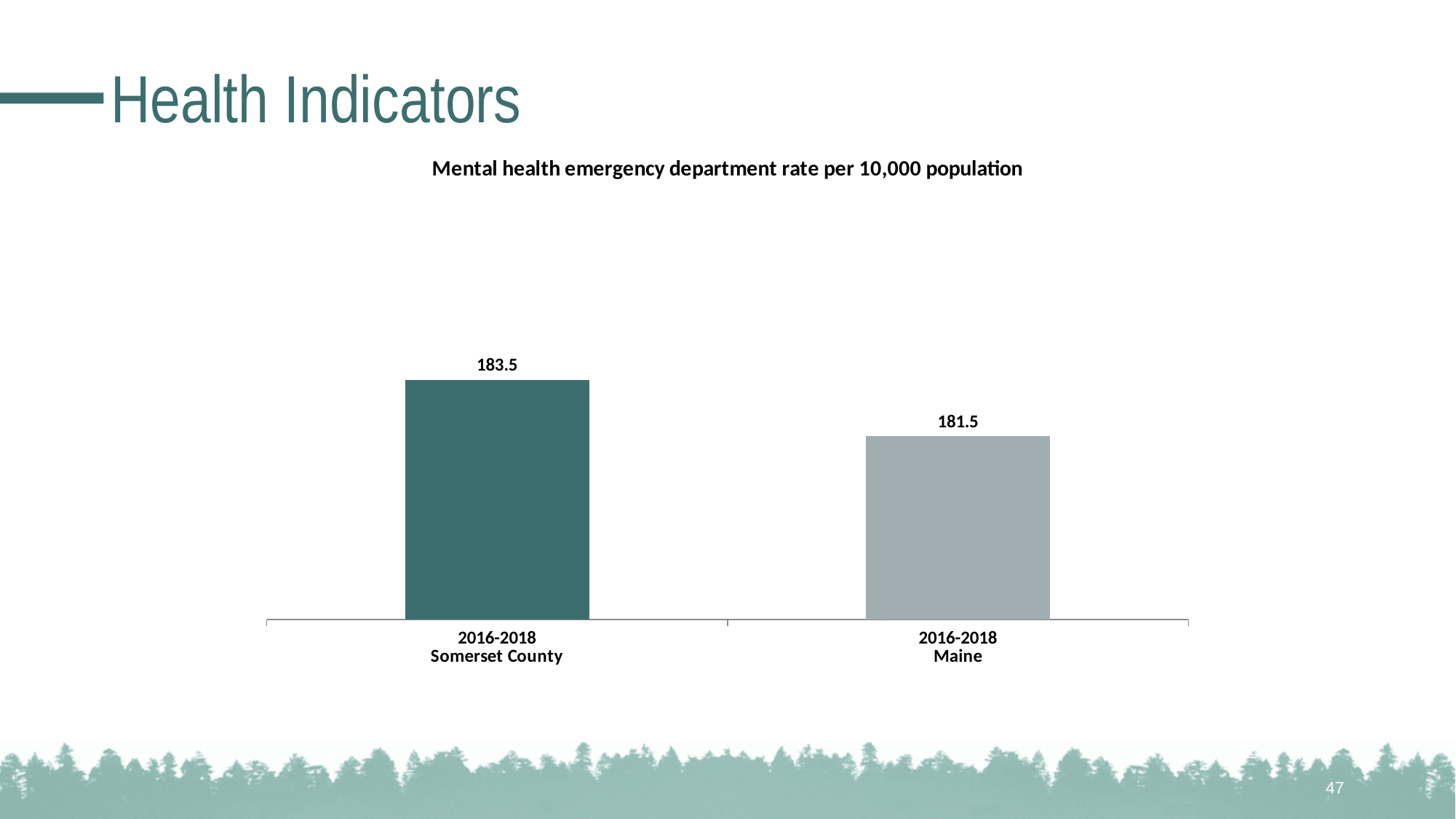
What is the difference between the Somerset County rate and the Maine rate? 2.0 Which category has the higher mental health emergency department rate, Somerset County or Maine? Somerset County Which bar shows the lowest value in the chart? 2016-2018 Maine What is the title of the chart? Mental health emergency department rate per 10,000 population How many bars are plotted in the chart? 2 What time period do both bars in the chart cover? 2016-2018 What is the mental health emergency department rate per 10,000 population for Maine (2016-2018)? 181.5 Which bar shows the highest value in the chart? 2016-2018 Somerset County What is the mental health emergency department rate per 10,000 population for Somerset County (2016-2018)? 183.5 What type of chart is shown on the slide? Bar chart